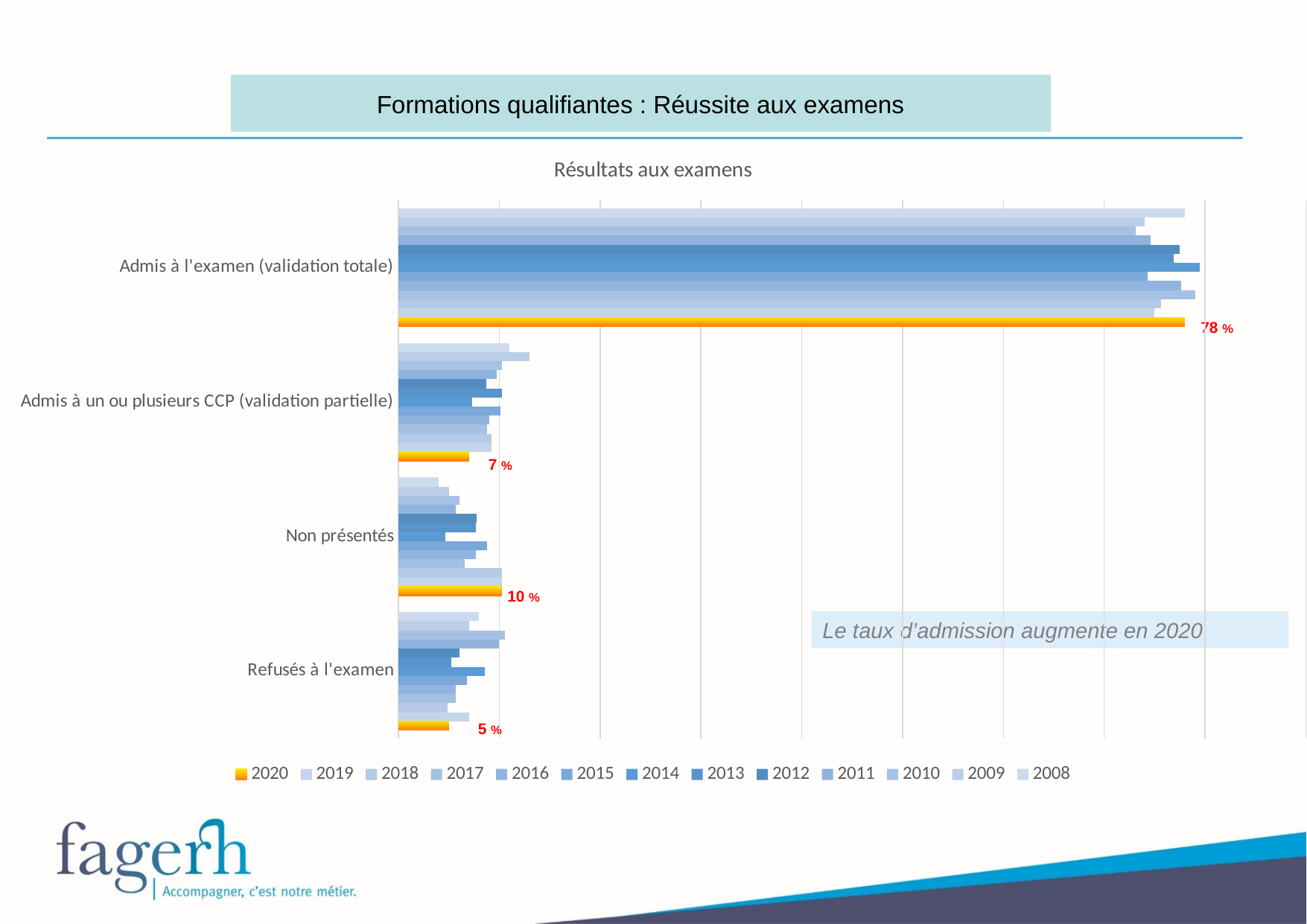
How many series does the legend list? 13 What is the title of the chart? Résultats aux examens What kind of chart is shown on the slide? Bar chart What is the difference between the 2020 values for "Admis à l'examen (validation totale)" and "Admis à un ou plusieurs CCP (validation partielle)"? 71 % Which category has the highest 2020 value? Admis à l'examen (validation totale) How many categories are shown on the chart? 4 What is the 2020 value for "Non présentés"? 10 % What is the 2020 value for "Admis à l'examen (validation totale)"? 78 % Which category has the lowest 2020 value? Refusés à l'examen What is the 2020 value for "Admis à un ou plusieurs CCP (validation partielle)"? 7 % What is the 2020 value for "Refusés à l'examen"? 5 % For 2020, which is larger: "Non présentés" or "Refusés à l'examen"? Non présentés